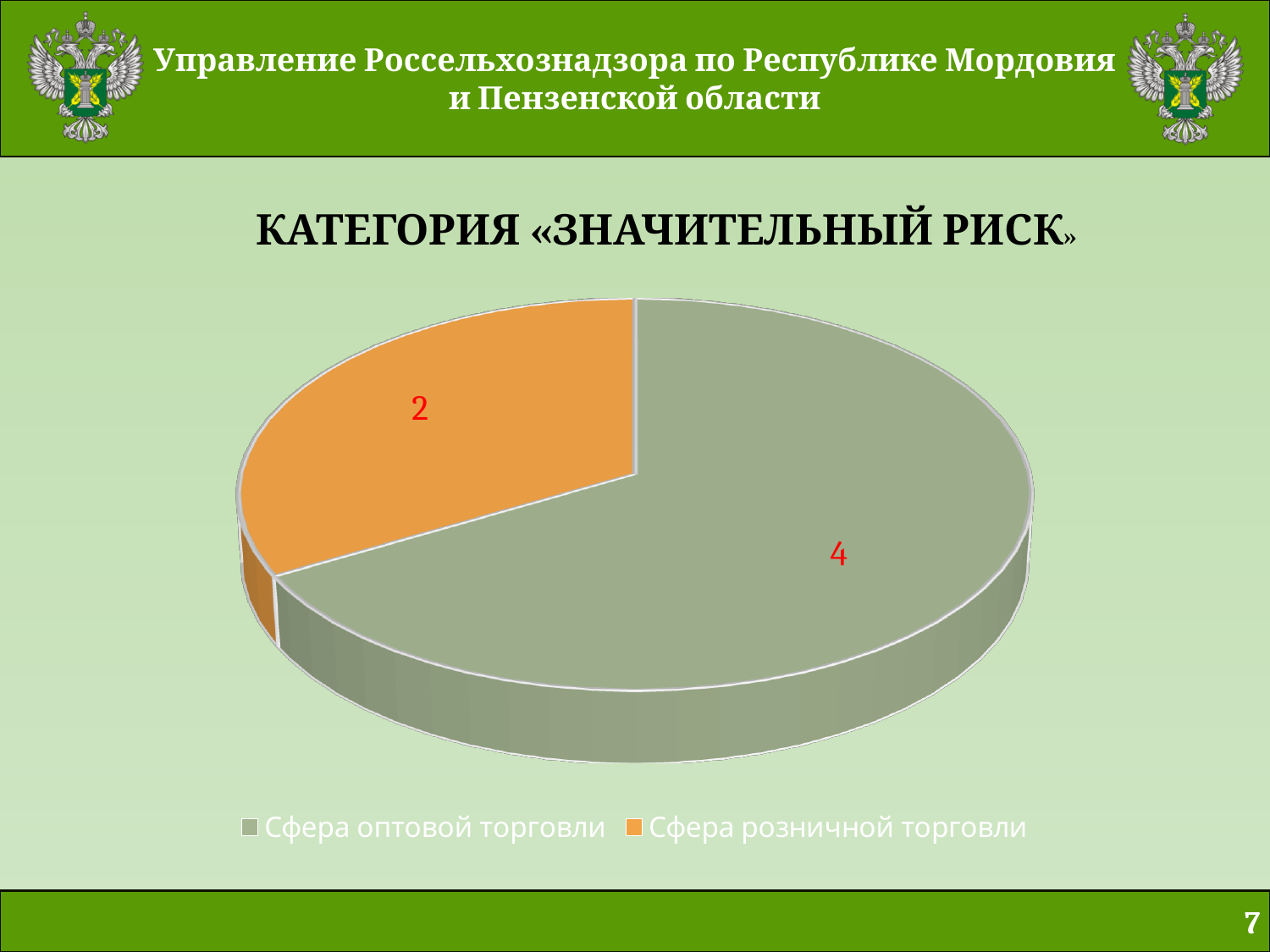
What is the value for Сфера розничной торговли? 2 What is the value for Сфера оптовой торговли? 4 What is the title of the chart? КАТЕГОРИЯ «ЗНАЧИТЕЛЬНЫЙ РИСК» Which category has the smallest slice of the pie? Сфера розничной торговли What type of chart is shown on the slide? pie chart How many slices does the pie chart have? 2 What is the difference between the values for Сфера оптовой торговли and Сфера розничной торговли? 2 What is the total of all slices in the pie chart? 6 How many entries does the legend list? 2 What fraction of the pie does Сфера оптовой торговли represent? 2/3 Which category has the largest slice of the pie? Сфера оптовой торговли Which is larger, the value for Сфера оптовой торговли or the value for Сфера розничной торговли? Сфера оптовой торговли